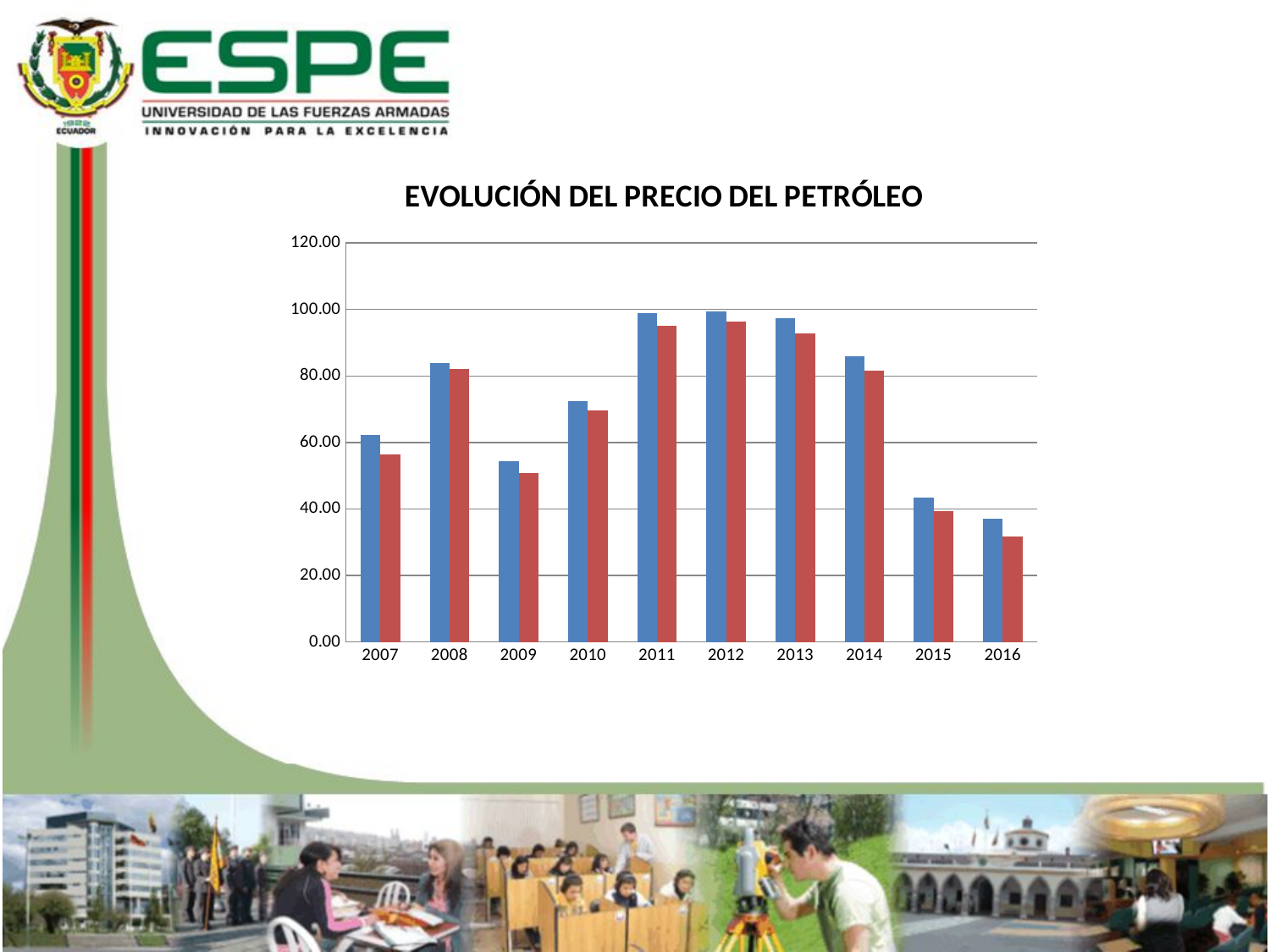
What is the title of the chart? EVOLUCIÓN DEL PRECIO DEL PETRÓLEO Is the value of the blue bar for 2014 greater or less than 80? greater In each year, which bar is taller, the blue one or the red one? the blue one Is the value of the red bar for 2007 greater or less than 60? less Is the value of the red bar for 2009 greater or less than 40? greater Which year has the larger blue bar, 2008 or 2009? 2008 How many years are shown on the x axis of the chart? 10 Do the values rise or fall from 2012 to 2016? fall What kind of chart is shown on the slide? bar chart Which year has the lowest values for both bars in the chart? 2016